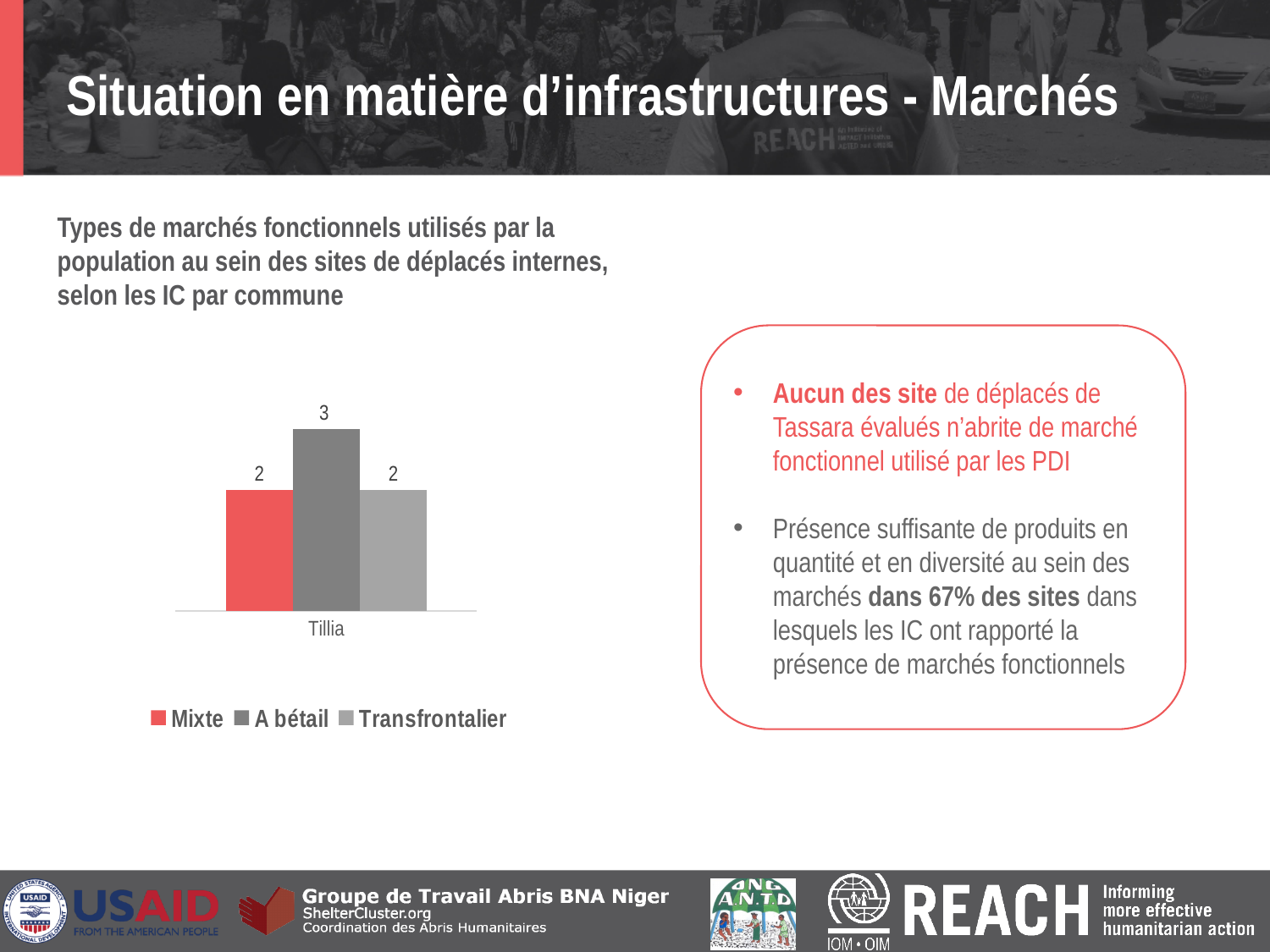
Which series is shown in red in the chart? Mixte What kind of chart is shown on the slide? Bar chart Which series has the highest value for Tillia? A bétail Which category label appears on the x axis of the chart? Tillia What is the value for the A bétail series for Tillia? 3 Which is larger for Tillia, the A bétail value or the Transfrontalier value? A bétail What is the total of the three series values for Tillia? 7 What is the value for the Mixte series for Tillia? 2 What is the value for the Transfrontalier series for Tillia? 2 What is the difference between the A bétail value and the Mixte value for Tillia? 1 How many series does the legend list? 3 How many categories are shown on the x axis? 1